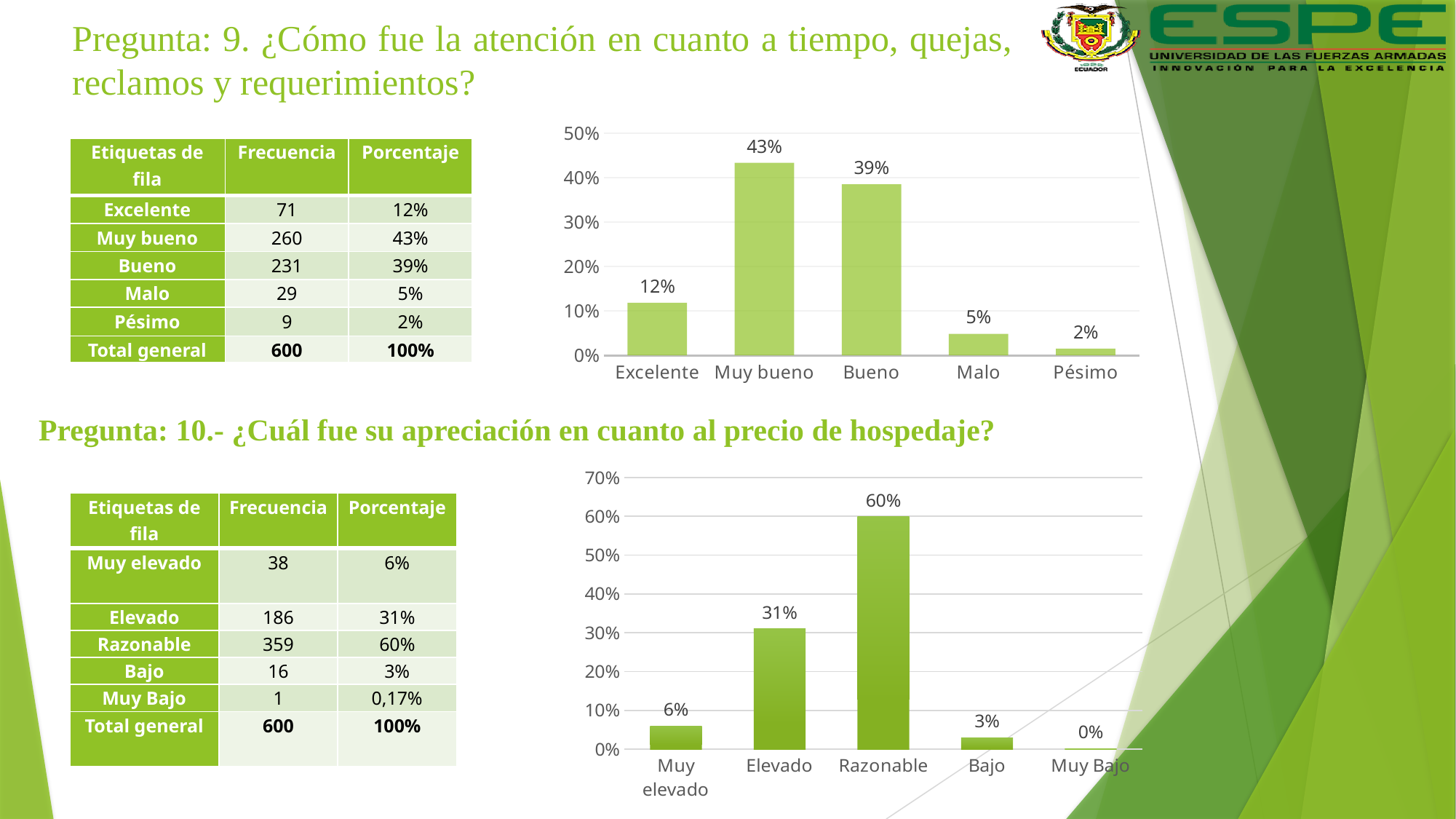
In the top chart, which category has the highest value? Muy bueno In the top chart, what is the value for Malo? 5% In the top chart, which category has the lowest value? Pésimo What kind of chart is the bottom chart? Bar chart In the bottom chart, what is the value for Razonable? 60% In the top chart, what is the difference between the values for Muy bueno and Bueno? 4% In the bottom chart, which category has the highest value? Razonable In the top chart, how many categories are shown on the x axis? 5 In the bottom chart, which is larger, the value for Muy elevado or the value for Bajo? Muy elevado In the bottom chart, what is the value for Elevado? 31% In the top chart, what is the value for Muy bueno? 43% In the bottom chart, what is the difference between the values for Razonable and Elevado? 29%